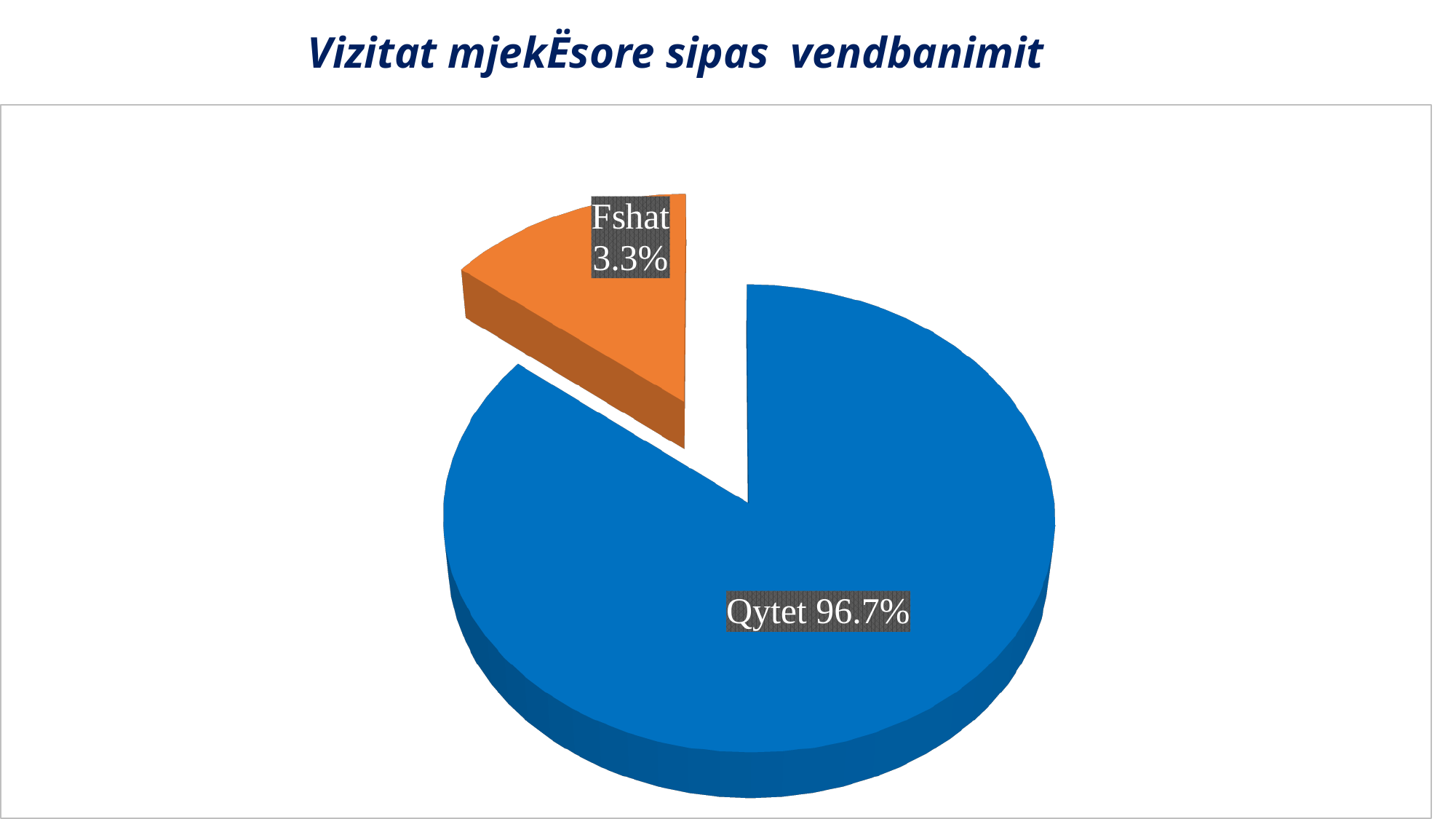
Which category has the largest slice of the pie? Qytet Which category has the smallest slice of the pie? Fshat What share of the pie does Fshat represent? 3.3% What is the difference in percentage points between the Qytet and Fshat slices? 93.4 Which slice is larger, Qytet or Fshat? Qytet What is the title of the chart on the slide? Vizitat mjekËsore sipas vendbanimit What colour is the Fshat slice? Orange What share of the pie does Qytet represent? 96.7% How many slices does the pie chart have? 2 What kind of chart is shown on the slide? Pie chart